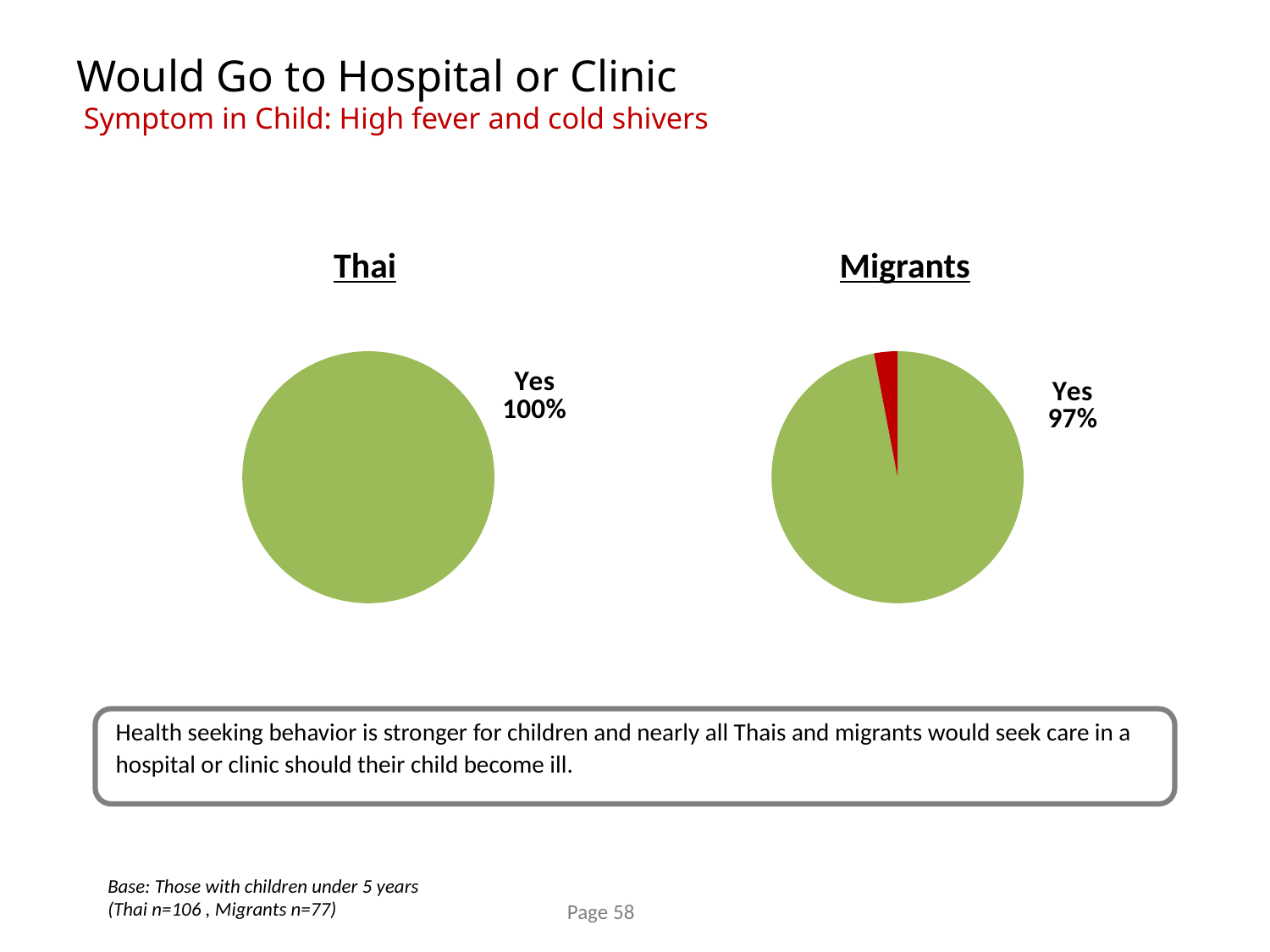
Which group has the higher Yes share, Thai or Migrants? Thai What colour is the Yes slice in both pie charts? Green What kind of chart is used for the Thai and Migrants data on this slide? Pie chart Is the Yes share in the Migrants pie chart greater or less than 90%? greater How many slices are visible in the Migrants pie chart? 2 In the Thai pie chart, what share of respondents answered Yes? 100% What is the title of the pie chart on the right side of the slide? Migrants What is the difference in the Yes share between the Thai and Migrants pie charts? 3% In the Migrants pie chart, what share is not labelled Yes (the red slice)? 3% In the Migrants pie chart, what share of respondents answered Yes? 97% How many slices are visible in the Thai pie chart? 1